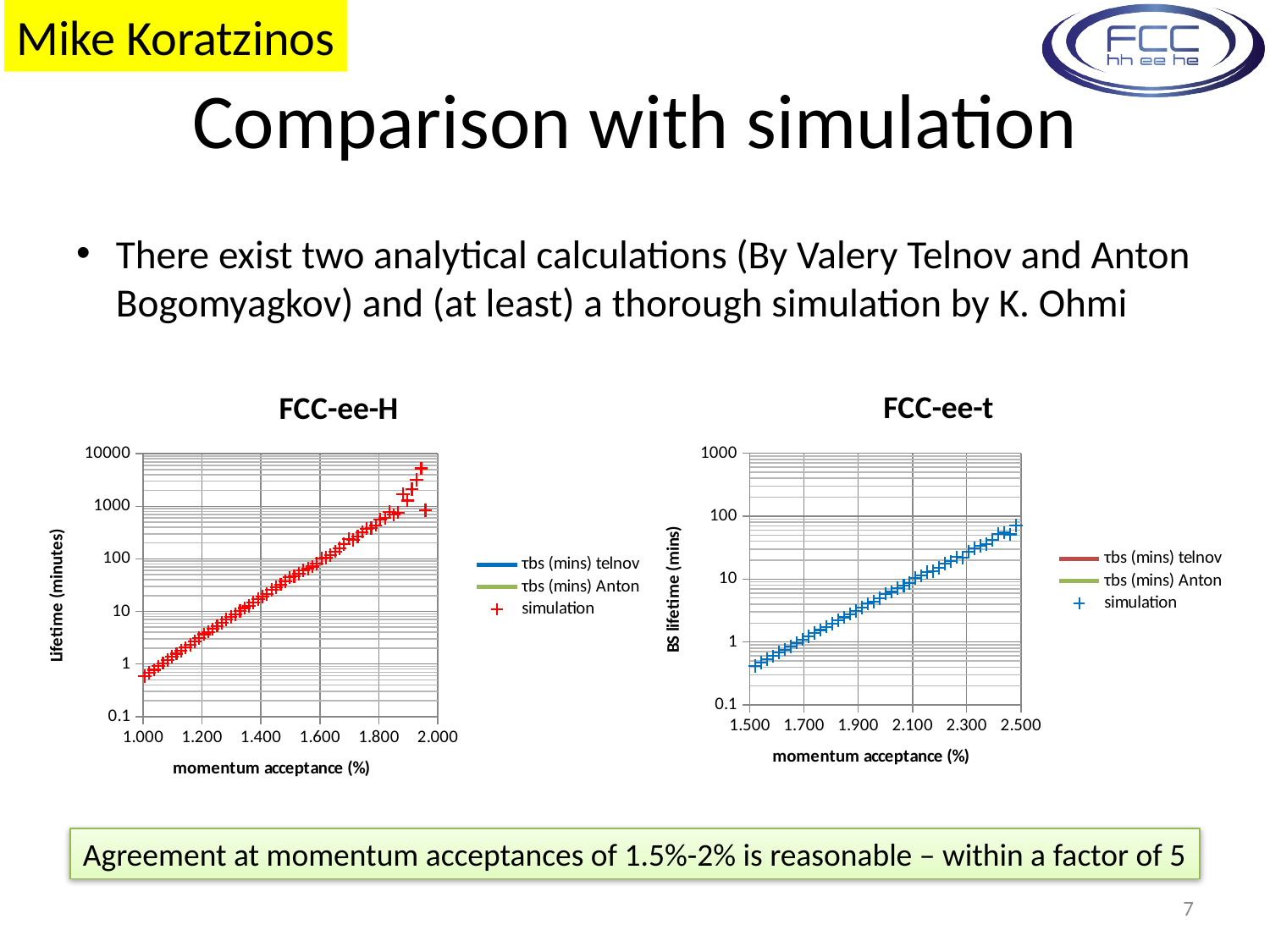
In the FCC-ee-t chart, do the simulation values rise or fall as momentum acceptance increases? rise What kind of chart is the FCC-ee-H chart? scatter chart In the FCC-ee-t chart, is the simulation value at a momentum acceptance of 1.500% greater or less than 1 minute? less In the FCC-ee-t chart, is the simulation value at a momentum acceptance of 2.500% greater or less than 10 minutes? greater In the FCC-ee-H chart, do the simulation values rise or fall as momentum acceptance increases? rise What is the x-axis label of the FCC-ee-t chart? momentum acceptance (%) How many series does the legend of the FCC-ee-H chart list? 3 In the FCC-ee-H chart, is the simulation value at a momentum acceptance of 1.800% greater or less than 100 minutes? greater What is the y-axis label of the FCC-ee-H chart? Lifetime (minutes) How many series does the legend of the FCC-ee-t chart list? 3